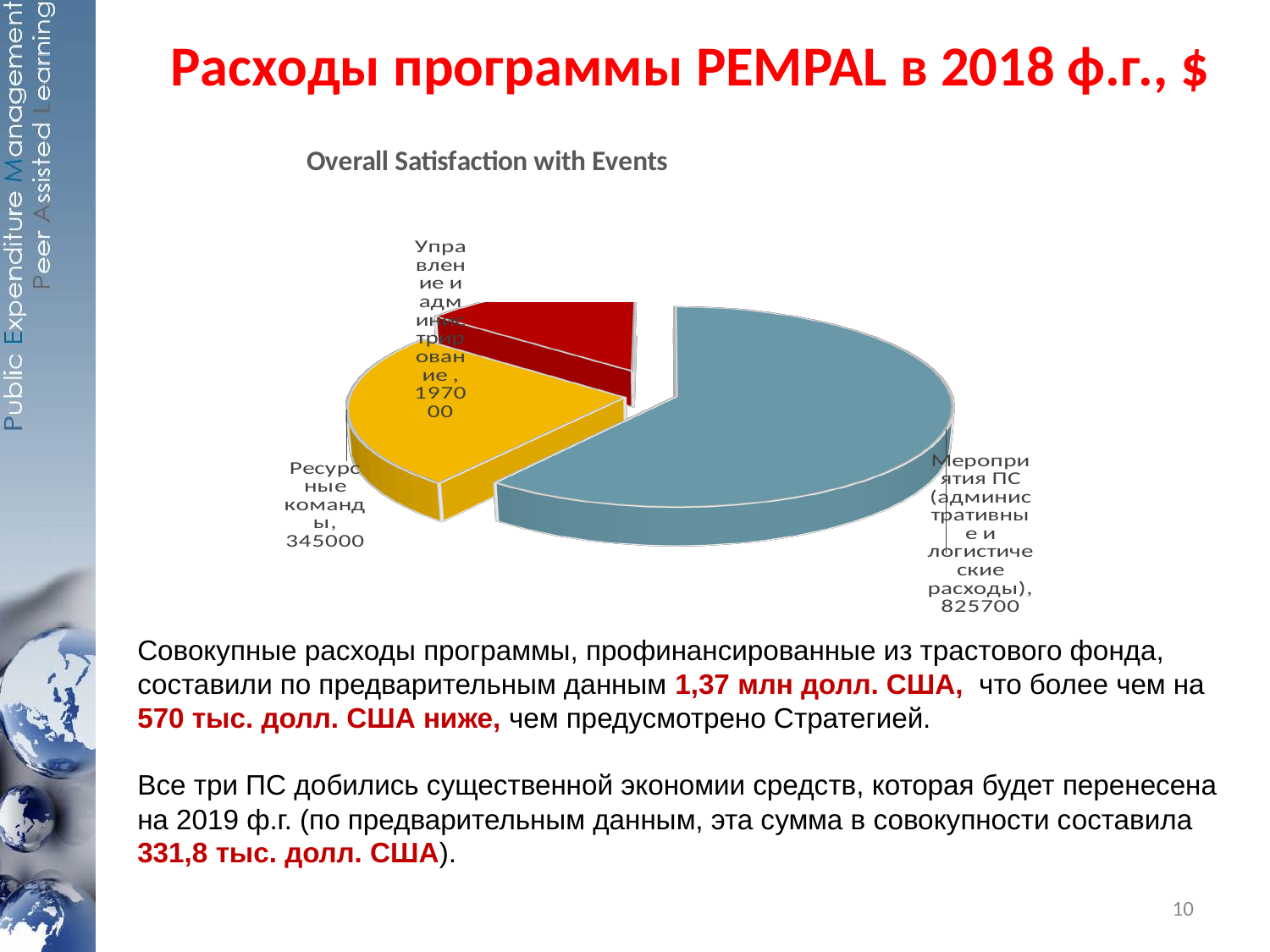
Which category has the largest slice of the pie? Мероприятия ПС (административные и логистические расходы) What is the difference between the values for Мероприятия ПС and Ресурсные команды? 480700 Which is larger, the value for Ресурсные команды or the value for Управление и администрирование? Ресурсные команды How many slices does the pie chart have? 3 What is the value for Ресурсные команды? 345000 What is the difference between the values for Ресурсные команды and Управление и администрирование? 148000 What is the total of all slices in the pie chart? 1367700 What is the value for Мероприятия ПС (административные и логистические расходы)? 825700 What is the value for Управление и администрирование? 197000 Which category has the smallest slice of the pie? Управление и администрирование What kind of chart is shown on the slide? pie chart What is the title printed above the pie chart? Overall Satisfaction with Events